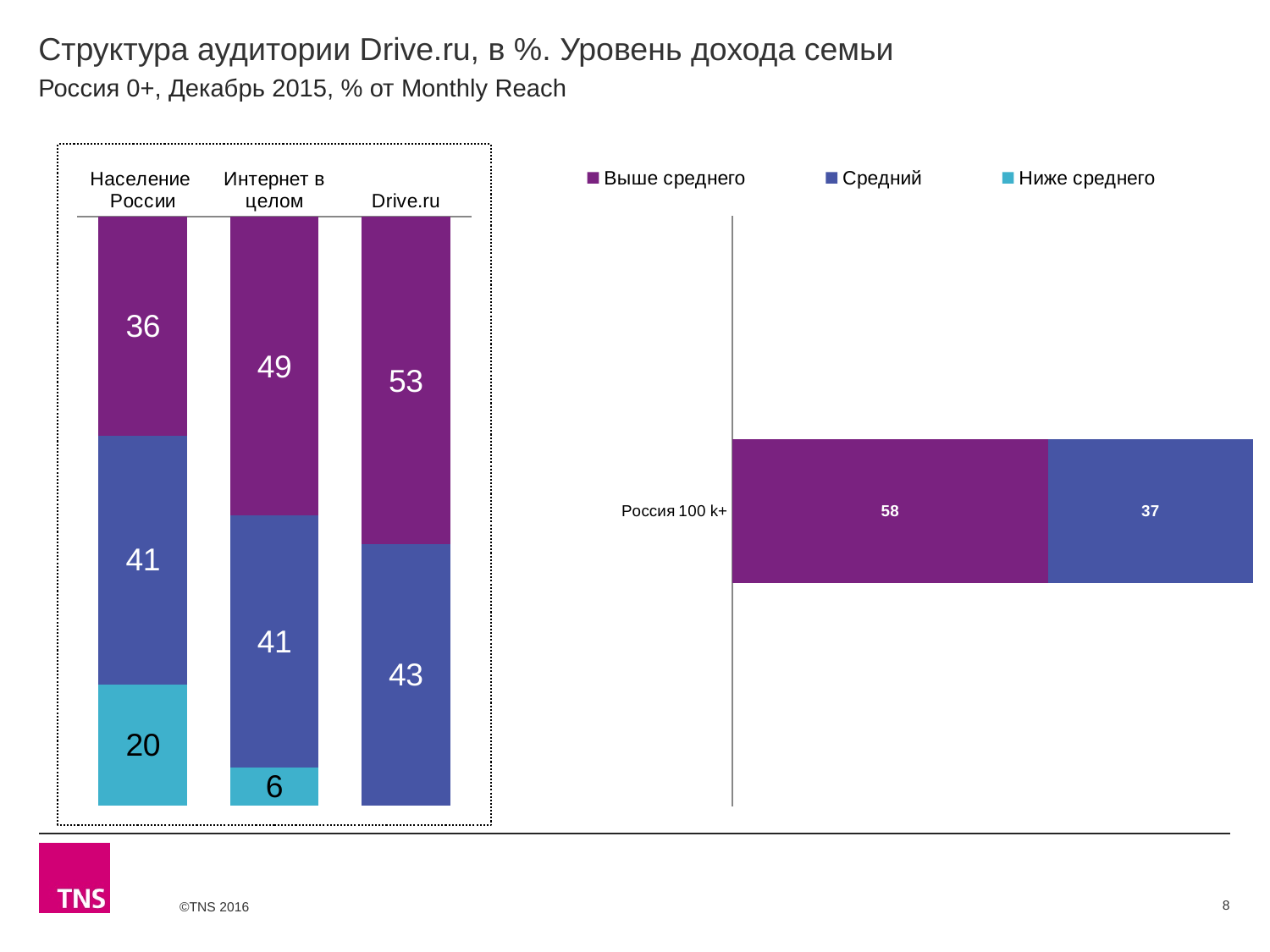
How many series does the legend list? 3 In the left chart, which is larger: the 'Средний' value for 'Drive.ru' or for 'Население России'? Drive.ru In the right chart, what is the 'Средний' value for 'Россия 100 k+'? 37 How many categories are shown in the left chart? 3 In the right chart, what is the 'Выше среднего' value for 'Россия 100 k+'? 58 In the left chart, what is the difference between the 'Выше среднего' values for 'Drive.ru' and 'Население России'? 17 In the left chart, what is the value of the 'Выше среднего' segment for 'Drive.ru'? 53 In the left chart, which category has the lowest 'Выше среднего' value? Население России In the left chart, which category has the highest 'Выше среднего' value? Drive.ru In the left chart, what is the value of the 'Средний' segment for 'Интернет в целом'? 41 In the left chart, what is the value of the 'Ниже среднего' segment for 'Интернет в целом'? 6 In the left chart, what is the value of the 'Ниже среднего' segment for 'Население России'? 20